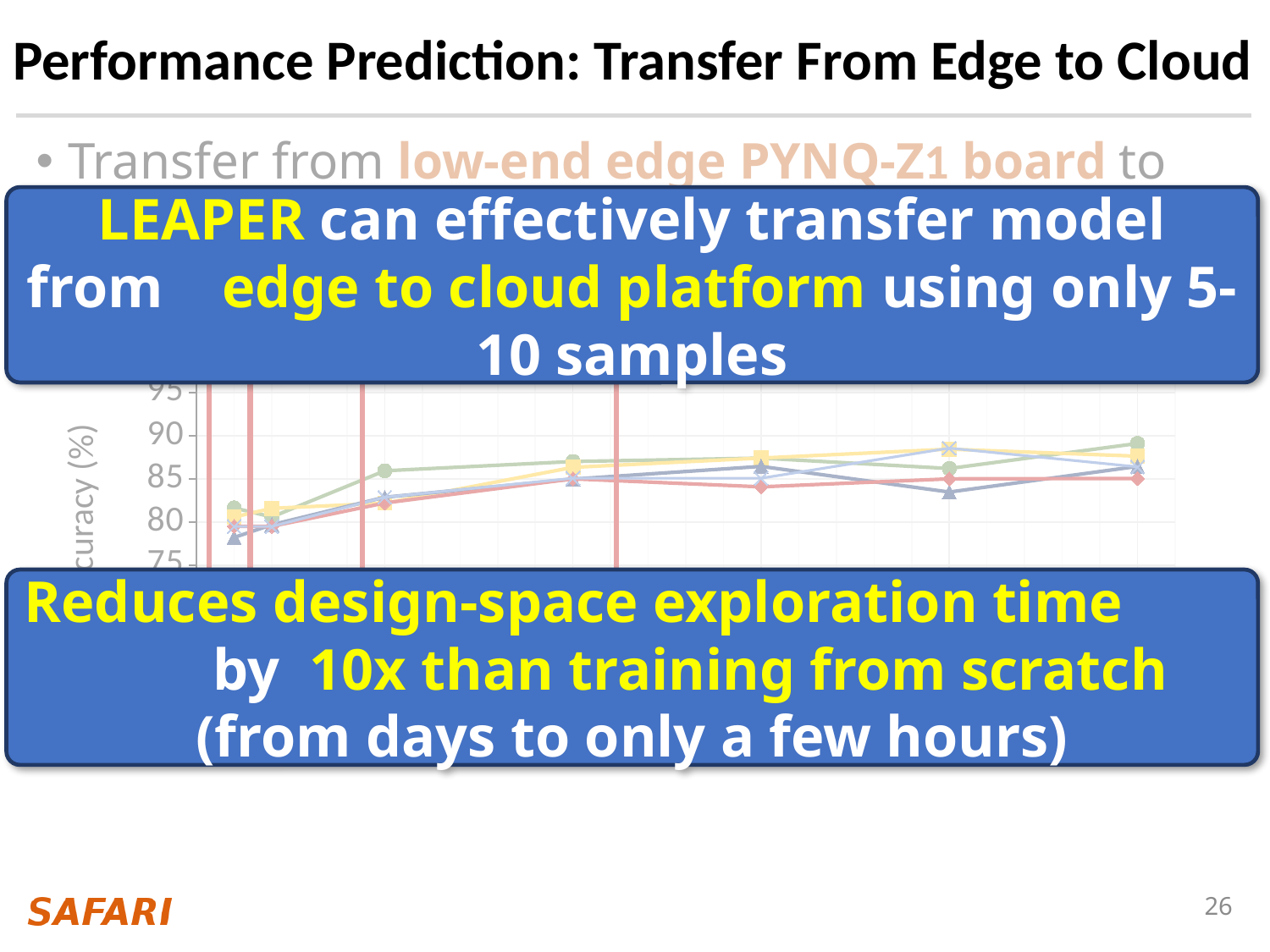
What kind of chart is shown on the slide? line chart Do the plotted values generally rise or fall from left to right along the x axis? rise Is the value of the green line at its rightmost point greater or less than 85? greater What is the lowest tick value shown on the y axis? 75 Is the value of the red line at its rightmost point greater or less than 90? less